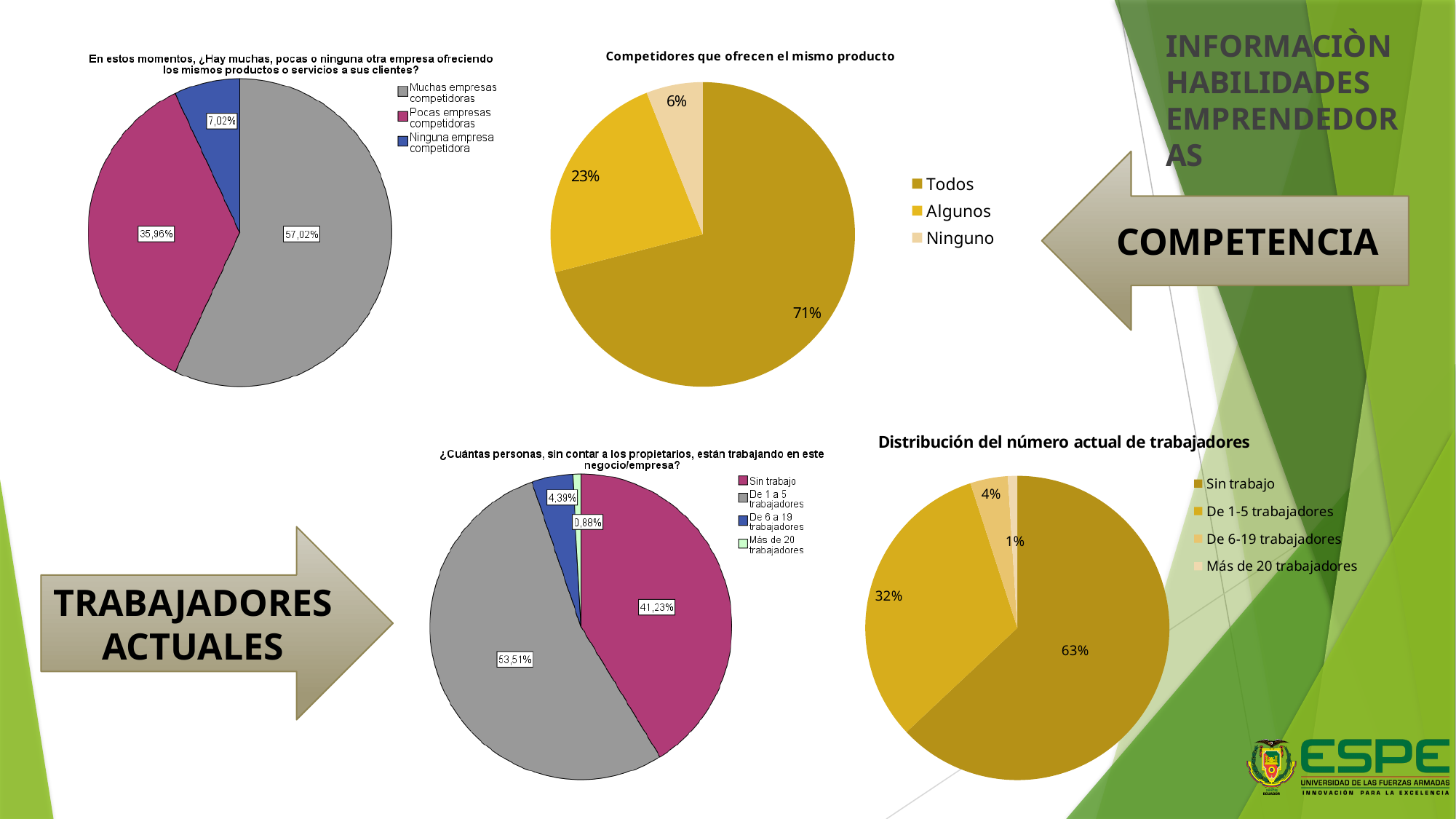
In the top-left pie chart about whether many, few or no other companies offer the same products, which category has the smallest slice? Ninguna empresa competidora In the 'Competidores que ofrecen el mismo producto' pie chart, what percentage is shown for 'Ninguno'? 6% In the 'Distribución del número actual de trabajadores' pie chart, which category has the largest slice? Sin trabajo In the bottom-middle pie chart about how many people work in the business, what percentage is shown for 'De 1 a 5 trabajadores'? 53,51% In the 'Competidores que ofrecen el mismo producto' pie chart, which category has the largest slice? Todos In the top-left pie chart about whether many, few or no other companies offer the same products, how many categories does the legend list? 3 In the 'Distribución del número actual de trabajadores' pie chart, how many categories does the legend list? 4 In the top-left pie chart about whether many, few or no other companies offer the same products, what percentage is shown for 'Muchas empresas competidoras'? 57,02% In the bottom-middle pie chart about how many people work in the business, which is larger: 'Sin trabajo' or 'De 6 a 19 trabajadores'? Sin trabajo In the 'Competidores que ofrecen el mismo producto' pie chart, what is the difference between the 'Todos' and 'Algunos' percentages? 48% In the 'Competidores que ofrecen el mismo producto' pie chart, what percentage is shown for 'Todos'? 71% In the 'Distribución del número actual de trabajadores' pie chart, what percentage is shown for 'De 1-5 trabajadores'? 32%